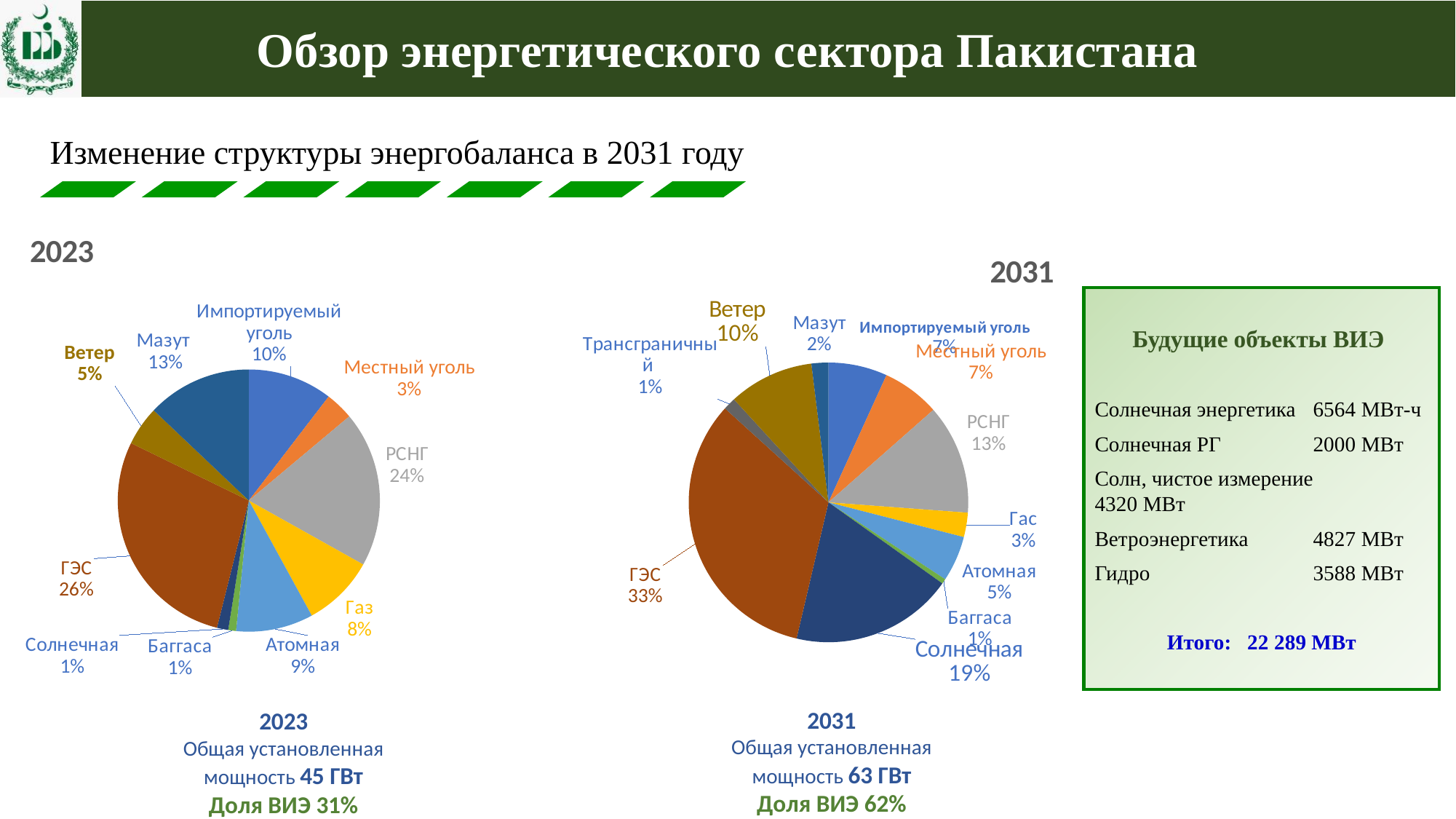
Сколько категорий показано на диаграмме 2031 года? 11 На диаграмме 2031 года что больше: доля Ветра или доля Мазута? Ветер На диаграмме 2023 года какая категория имеет наибольшую долю? ГЭС Какая доля ВИЭ указана под диаграммой 2031 года? 62% На диаграмме 2031 года какая доля приходится на солнечную энергетику (Солнечная)? 19% Какого типа диаграммы показаны на слайде? Круговые диаграммы Сколько категорий показано на диаграмме 2023 года? 10 На диаграмме 2023 года на сколько процентных пунктов доля Мазута больше доли Ветра? 8 На диаграмме 2023 года какая доля приходится на ГЭС? 26% На диаграмме 2031 года на сколько процентных пунктов доля ГЭС больше доли РСНГ? 20 На диаграмме 2031 года какая категория имеет наибольшую долю? ГЭС На диаграмме 2023 года какая доля приходится на РСНГ? 24%